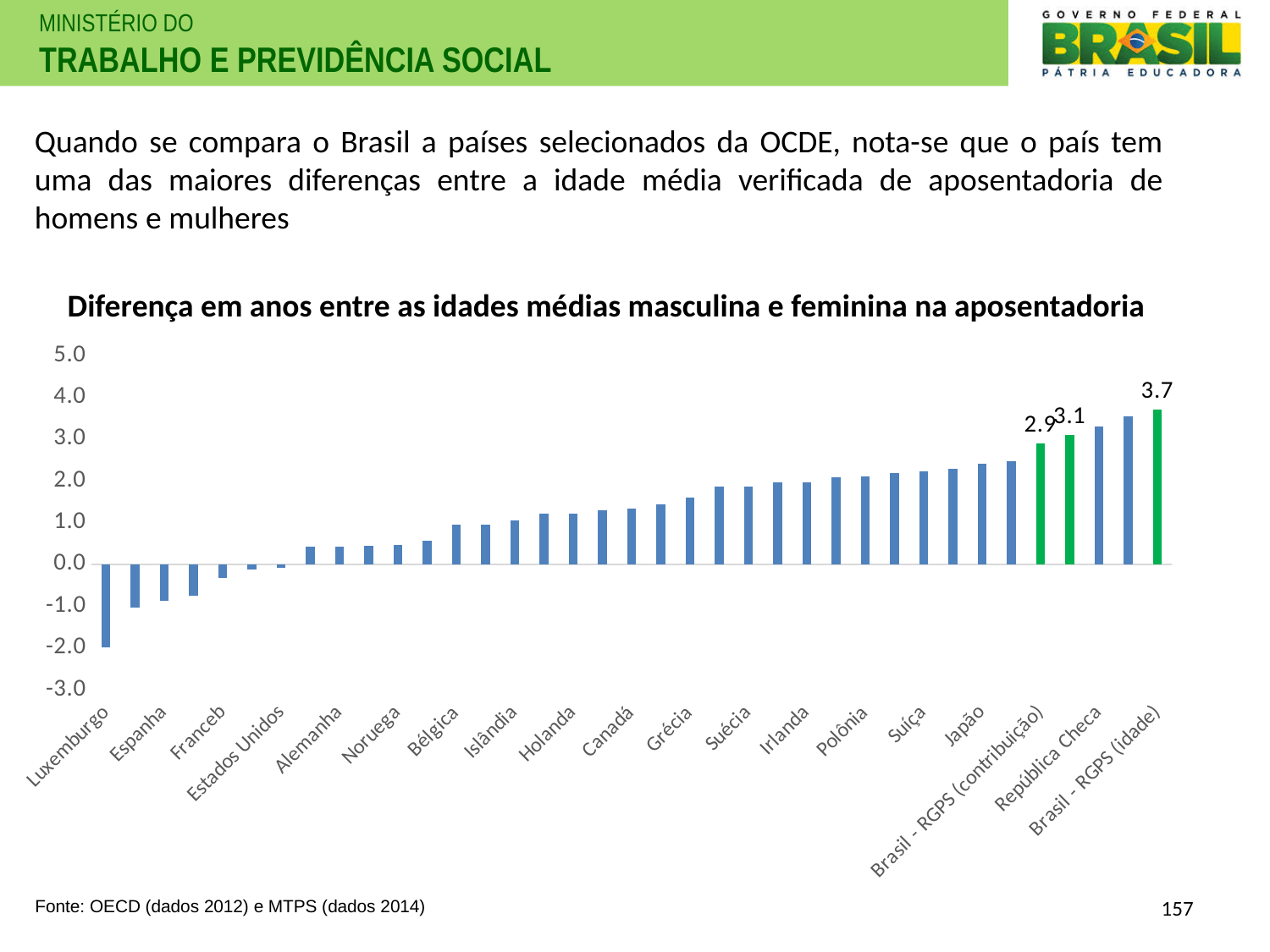
What is the title of the chart? Diferença em anos entre as idades médias masculina e feminina na aposentadoria Is the value for Luxemburgo greater or less than -1.0? less Which category has the highest value? Brasil - RGPS (idade) How many bars have a printed data label? 3 What is the value for Brasil - RGPS (contribuição)? 2.9 Do the values generally rise or fall from left to right along the x axis? rise Is the value for Brasil - RGPS (idade) greater or less than 3.0? greater What is the difference between the values for Brasil - RGPS (idade) and Brasil - RGPS (contribuição)? 0.8 Which category has the lowest value? Luxemburgo Which is larger, the value for Brasil - RGPS (idade) or Brasil - RGPS (contribuição)? Brasil - RGPS (idade) What is the value for Brasil - RGPS (idade)? 3.7 What type of chart is shown on the slide? bar chart